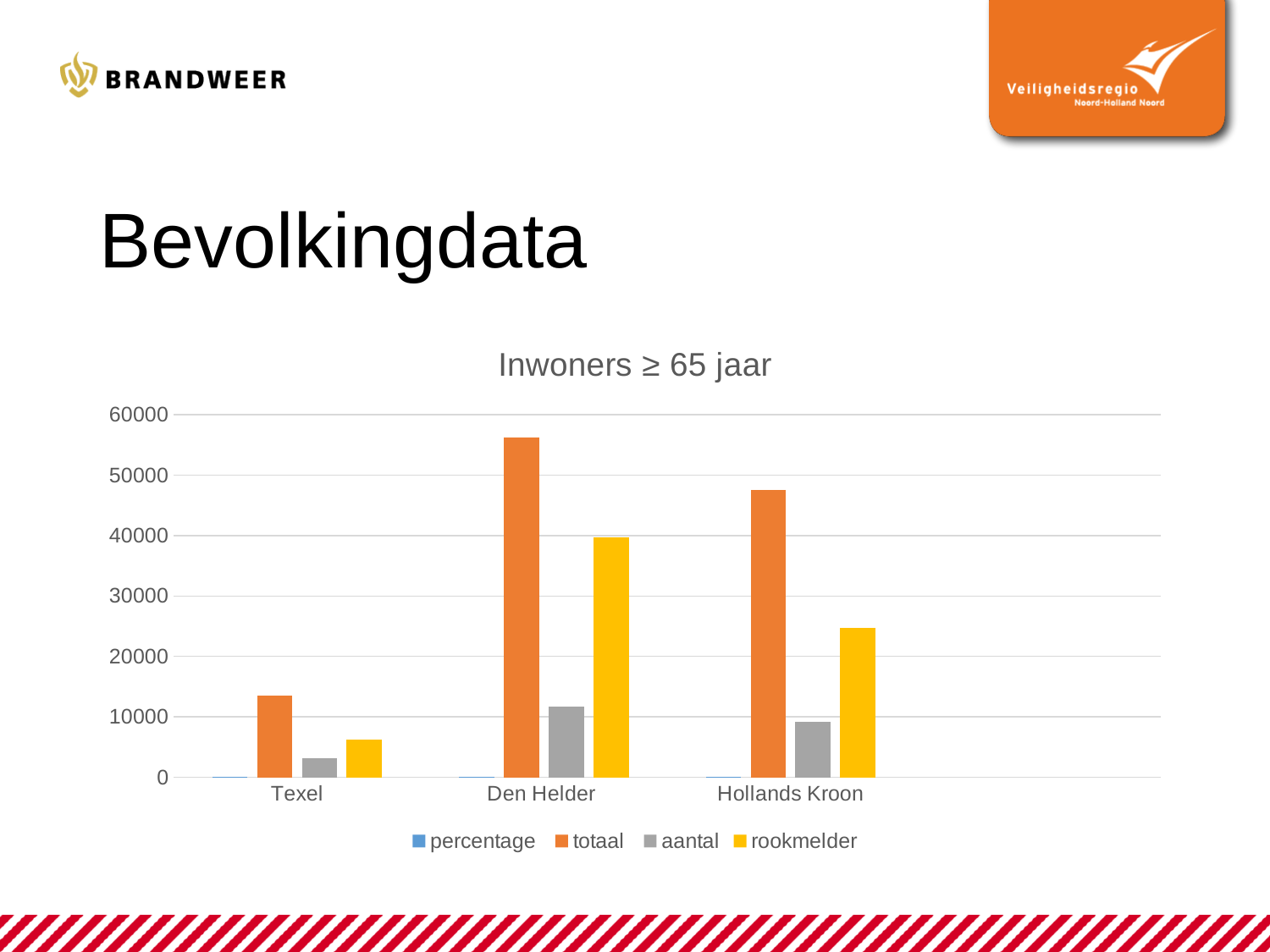
How many series does the legend list? 4 Which category has the highest value for the totaal series? Den Helder Is the rookmelder value for Hollands Kroon greater or less than 20000? greater Is the aantal value for Hollands Kroon greater or less than 10000? less Which colour represents the rookmelder series in the legend? yellow Is the totaal value for Texel greater or less than 10000? greater What kind of chart is shown on the slide? bar chart What is the title of the chart? Inwoners ≥ 65 jaar Which category has the lowest value for the totaal series? Texel Which is larger, the rookmelder value for Den Helder or the rookmelder value for Hollands Kroon? Den Helder How many categories are shown on the x axis? 3